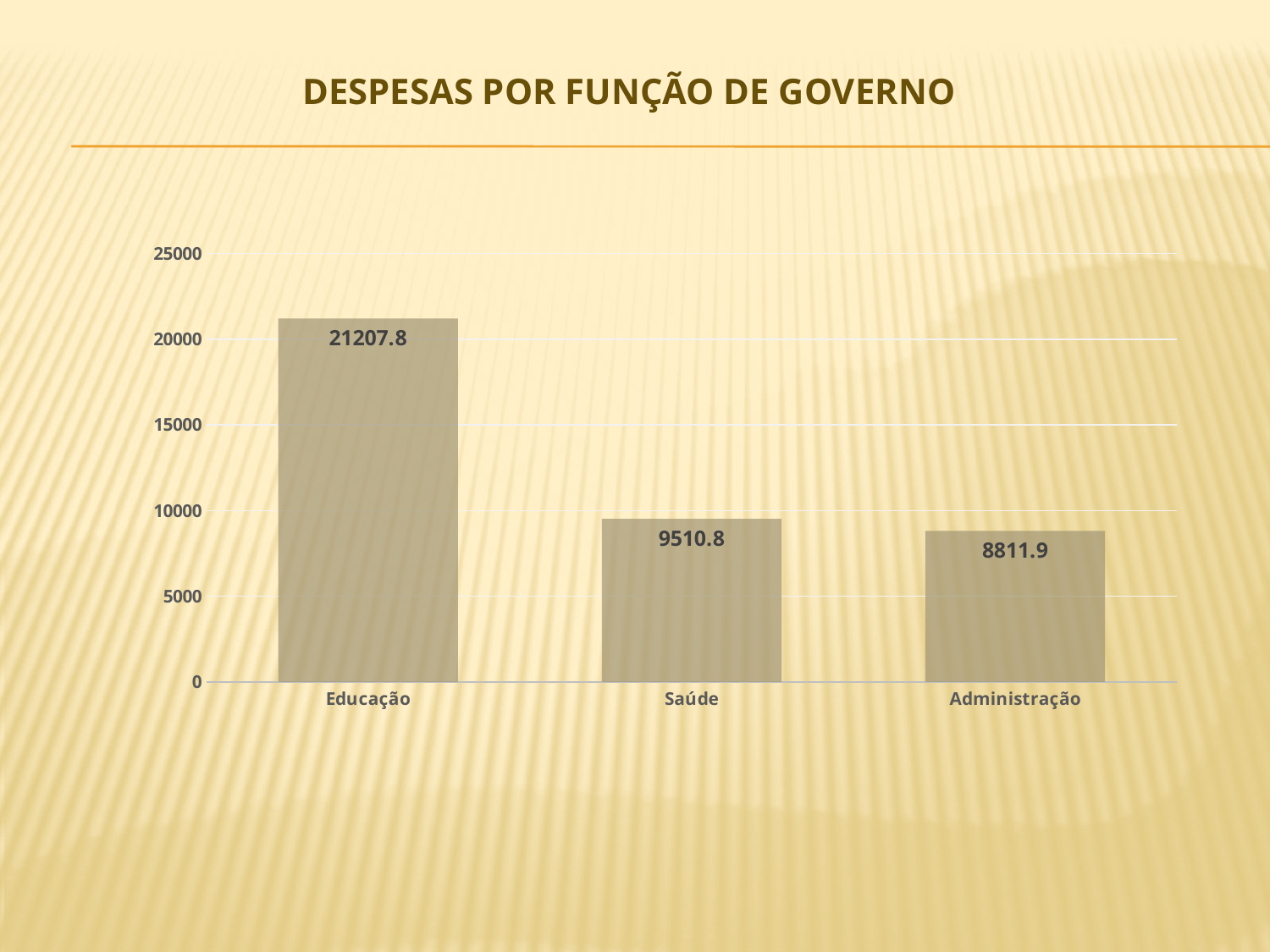
What is the difference between the values for Educação and Saúde? 11697 What is the title of the slide? DESPESAS POR FUNÇÃO DE GOVERNO Which is larger, the value for Saúde or the value for Administração? Saúde What is the value for Administração? 8811.9 How many categories are shown in the chart? 3 What is the difference between the values for Saúde and Administração? 698.9 What is the value for Educação? 21207.8 Is the value for Educação greater or less than 20000? greater Which category has the highest value? Educação Which category has the lowest value? Administração What kind of chart is shown on the slide? bar chart What is the value for Saúde? 9510.8